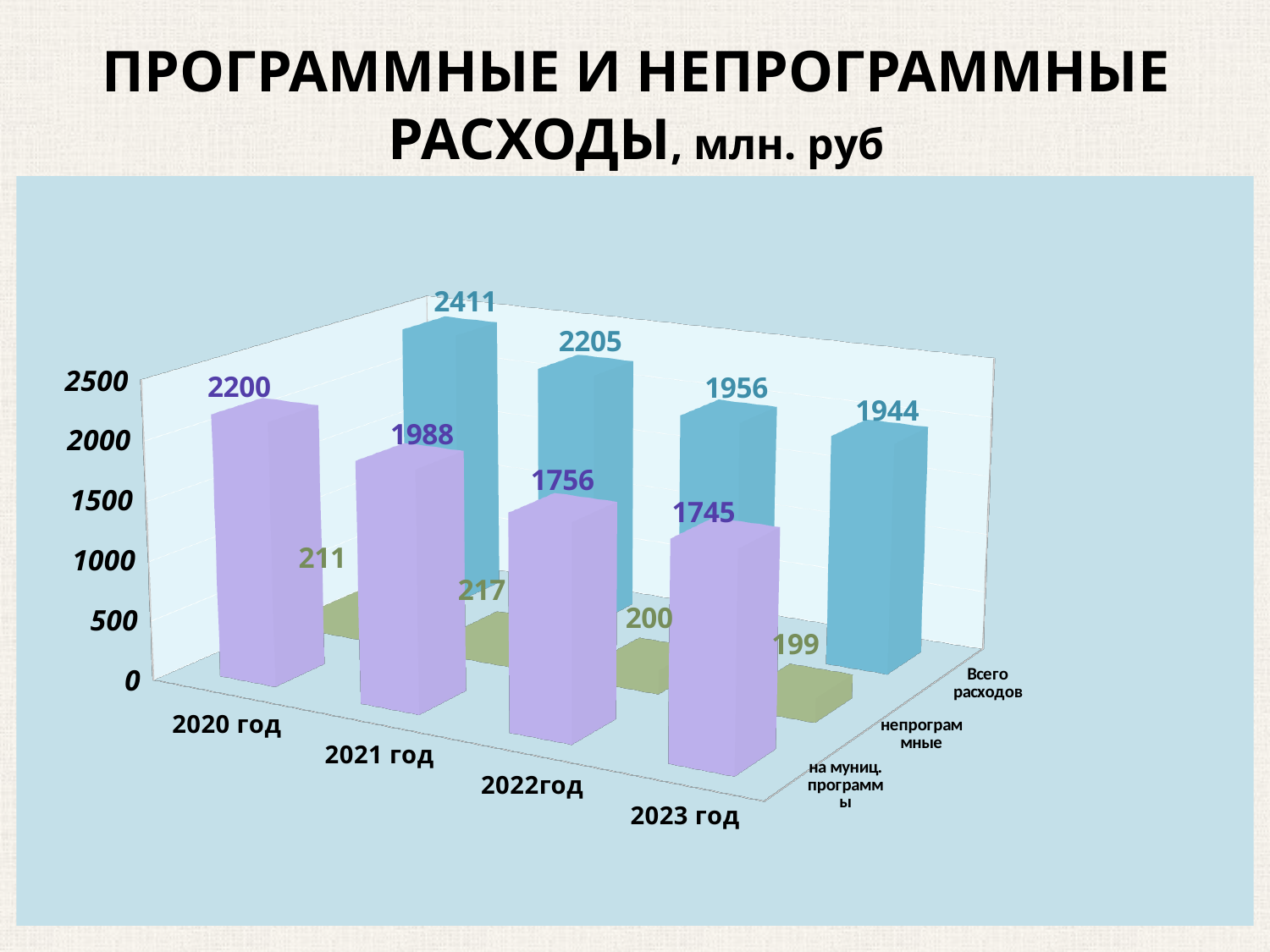
How many years are shown on the x axis? 4 What kind of chart is shown on the slide? bar chart In which year is 'Всего расходов' highest? 2020 год What is the value for 'Всего расходов' in 2022год? 1956 Which is larger: 'на муниц. программы' in 2021 год or in 2022год? 2021 год What is the difference between 'Всего расходов' in 2020 год and 2021 год? 206 Do the values for 'на муниц. программы' rise or fall from 2020 год to 2023 год? fall What is the value for 'Всего расходов' in 2023 год? 1944 What is the value for 'непрограммные' in 2021 год? 217 In which year is 'непрограммные' lowest? 2023 год How many data series does the chart show? 3 What is the value for 'на муниц. программы' in 2020 год? 2200